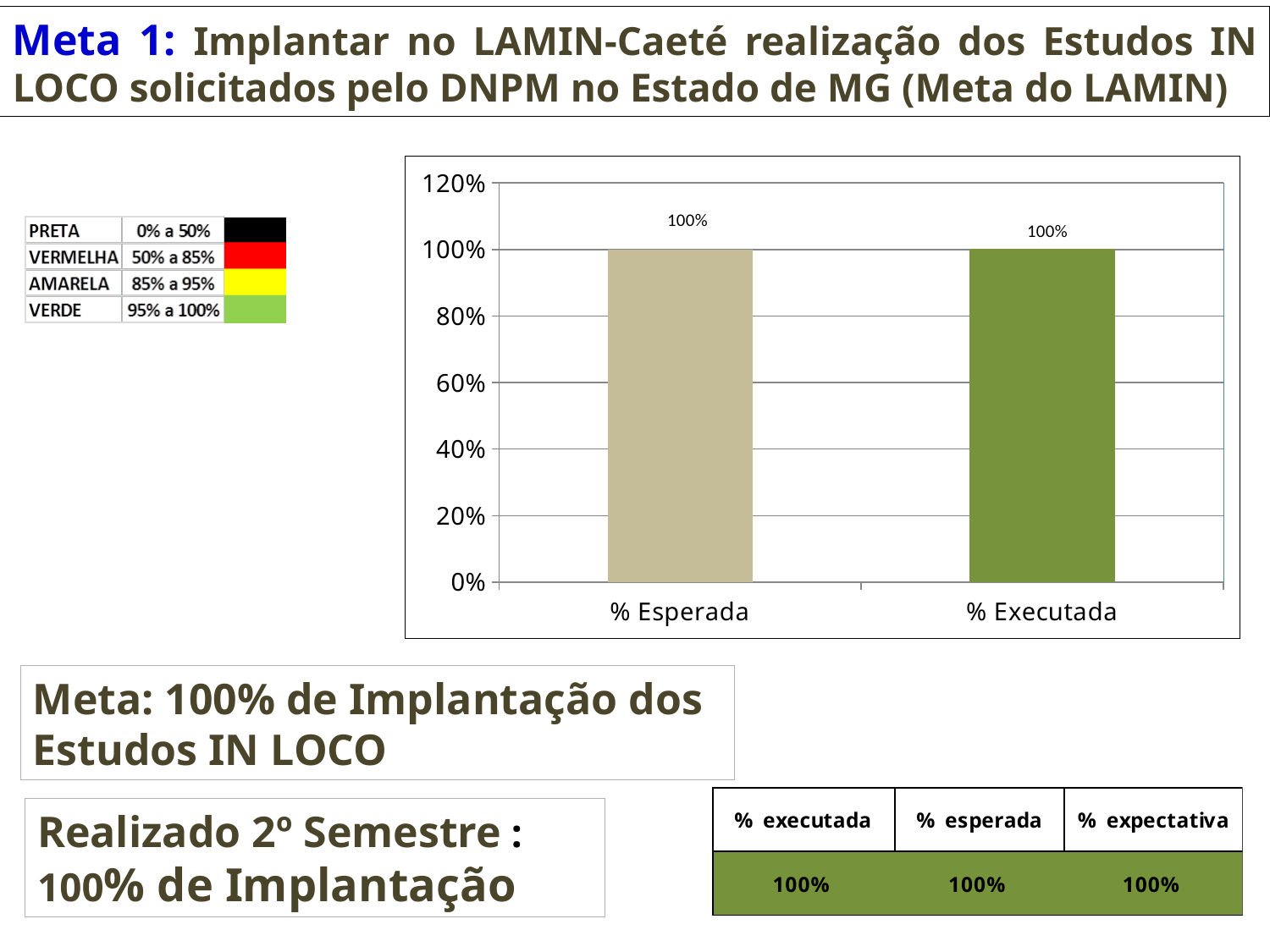
Is the value for % Executada greater or less than 80%? greater What is the highest value shown on the vertical axis of the chart? 120% What is the difference between the % Executada and % Esperada values? 0% Is the value for % Esperada greater or less than 60%? greater What are the two category labels on the horizontal axis of the chart? % Esperada and % Executada What kind of chart is shown on the slide? Bar chart What is the value of the % Esperada bar? 100% How many bars are plotted in the chart? 2 What is the value of the % Executada bar? 100%